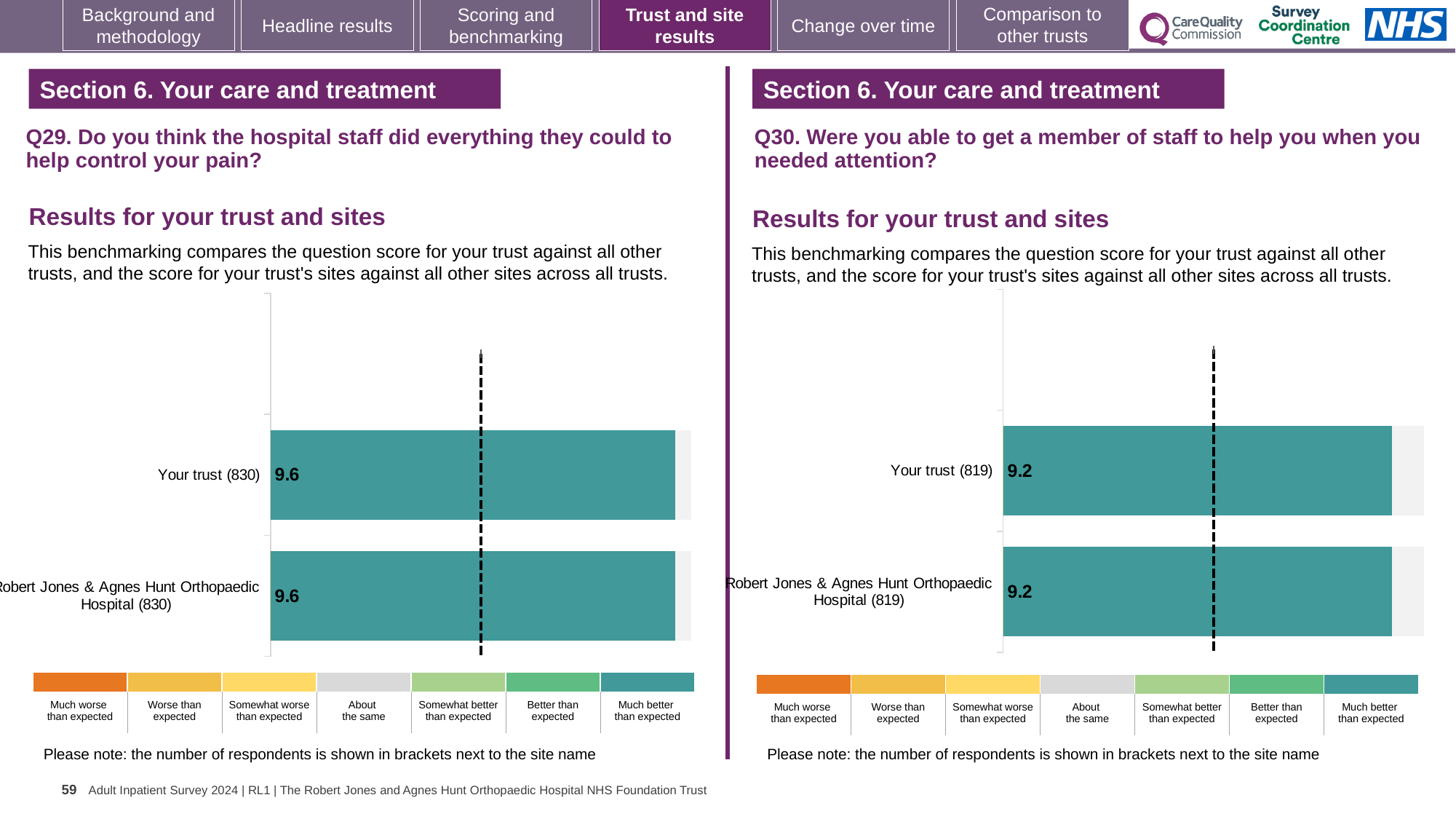
What kind of chart is used on the Q29 chart (left)? Bar chart On the Q29 chart (left), what is the score for Your trust (830)? 9.6 Is the score for Your trust on the Q29 chart (left) larger than the score for Your trust on the Q30 chart (right)? Yes How many bars are plotted on the Q29 chart (left)? 2 On the Q29 chart (left), what is the score for Robert Jones & Agnes Hunt Orthopaedic Hospital (830)? 9.6 How many respondents are shown in brackets for Your trust on the Q30 chart (right)? 819 On the Q29 chart (left), what is the difference between the score for Your trust and the score for Robert Jones & Agnes Hunt Orthopaedic Hospital? 0 On the Q30 chart (right), what is the difference between the score for Your trust and the score for Robert Jones & Agnes Hunt Orthopaedic Hospital? 0 On the Q30 chart (right), what is the score for Robert Jones & Agnes Hunt Orthopaedic Hospital (819)? 9.2 How many bars are plotted on the Q30 chart (right)? 2 How many categories does the colour key below the Q29 chart (left) list? 7 On the Q30 chart (right), what is the score for Your trust (819)? 9.2